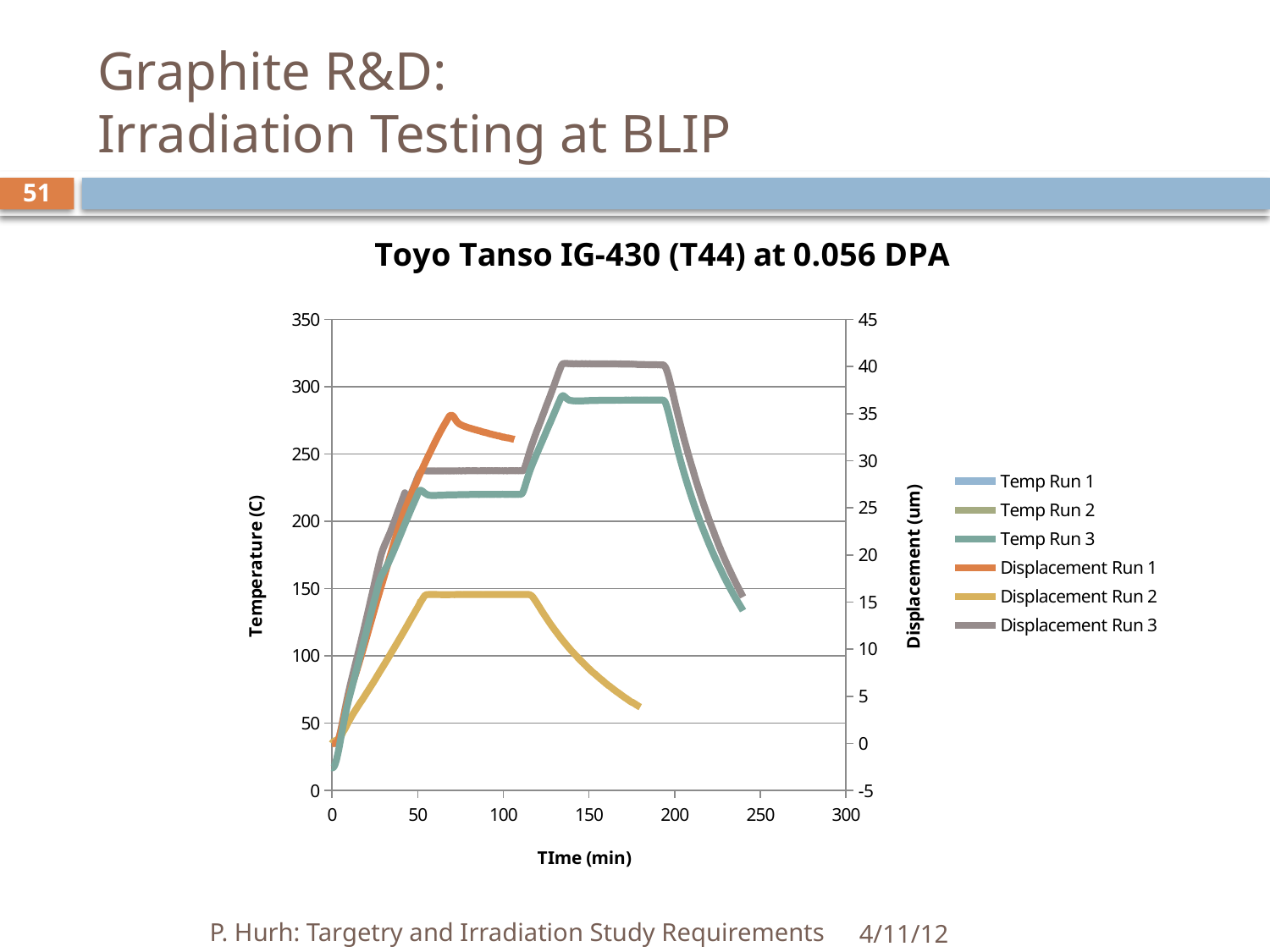
Does Displacement Run 2 rise or fall between about 120 min and 180 min? fall What is the highest value shown on the left temperature axis? 350 How many series does the legend list? 6 What kind of chart is shown on the slide? line chart What is the label of the right-hand vertical axis? Displacement (um) Is the final displacement value of Displacement Run 2 (at about 180 min) greater or less than 10 um? less Which displacement run has the lowest peak displacement? Displacement Run 2 What is the title of the chart? Toyo Tanso IG-430 (T44) at 0.056 DPA Is the peak displacement of Displacement Run 3 greater or less than 35 um on the right axis? greater Is the peak temperature of Temp Run 3 greater or less than 250 C? greater Which has the higher peak displacement, Displacement Run 3 or Displacement Run 2? Displacement Run 3 Which displacement run reaches the highest peak displacement? Displacement Run 3